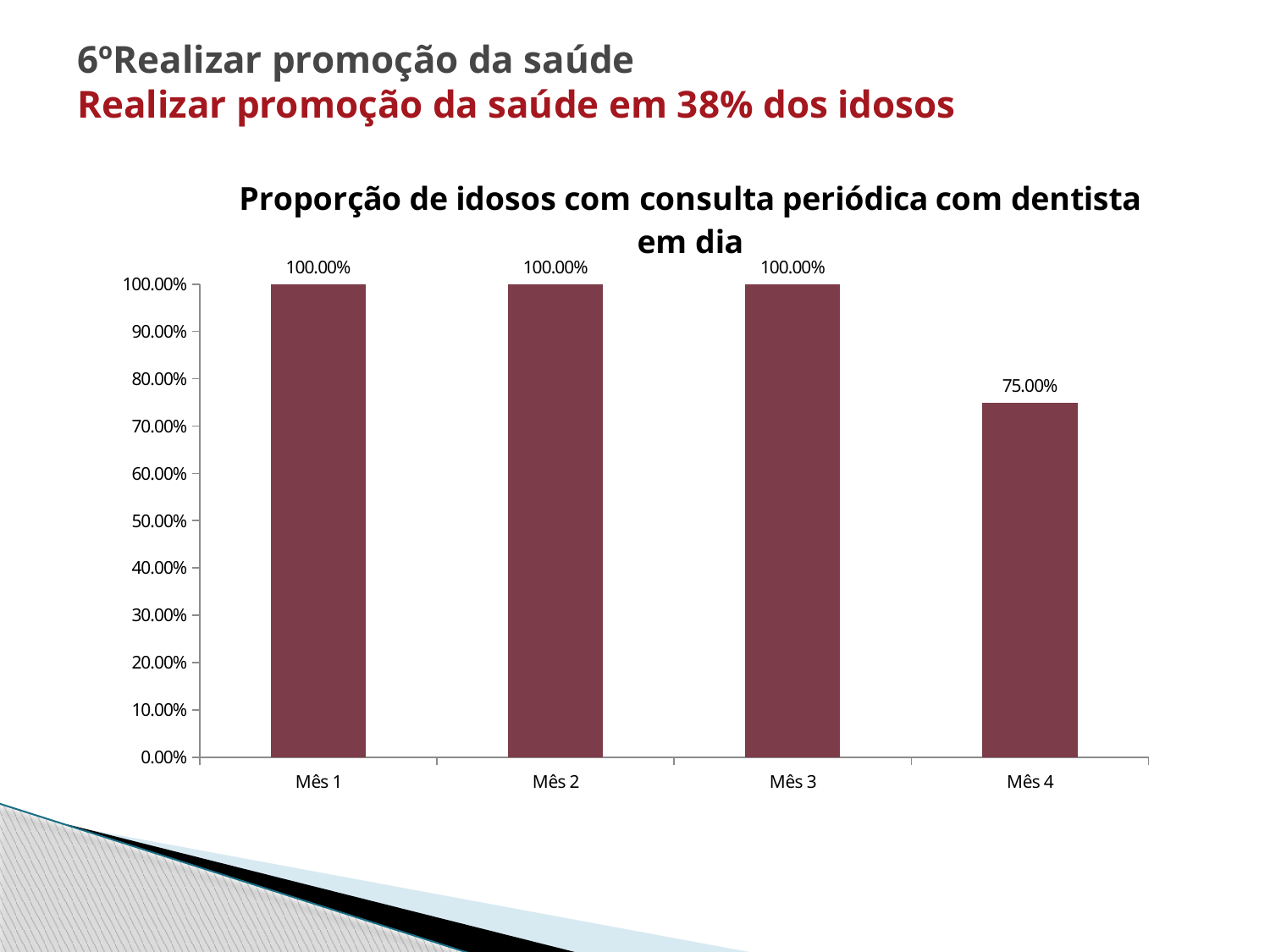
How many months have a value of 100.00%? 3 What is the value for Mês 4? 75.00% What is the title of the chart? Proporção de idosos com consulta periódica com dentista em dia Which month has the lowest value? Mês 4 What is the value for Mês 3? 100.00% How many months are shown on the x axis? 4 What is the value for Mês 1? 100.00% What kind of chart is shown on the slide? bar chart Is the value for Mês 4 greater or less than 80.00%? less Do the values rise, fall or stay the same from Mês 3 to Mês 4? fall Which is larger, the value for Mês 2 or the value for Mês 4? Mês 2 What is the difference between the values for Mês 3 and Mês 4? 25.00%